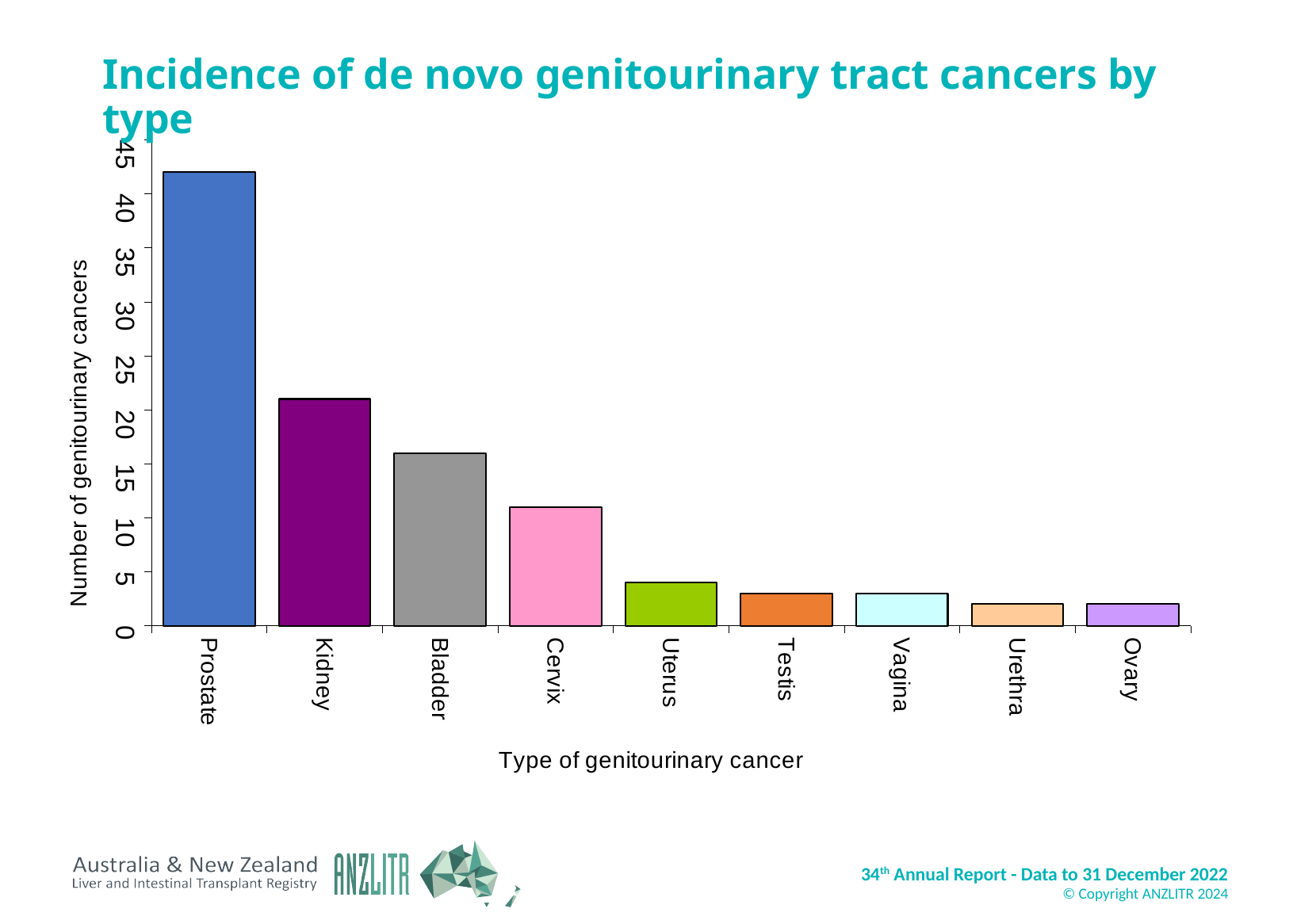
Is the value for Bladder greater or less than 15? greater Do the bar values rise or fall moving from left to right along the x axis? fall Which has more cases, Cervix or Uterus? Cervix What is the label of the y axis? Number of genitourinary cancers Which has more cases, Kidney or Bladder? Kidney How many types of genitourinary cancer are shown on the x axis? 9 What kind of chart is shown on the slide? bar chart Is the value for Prostate greater or less than 40? greater Is the value for Cervix greater or less than 10? greater Which type of genitourinary cancer has the highest number of cases? Prostate